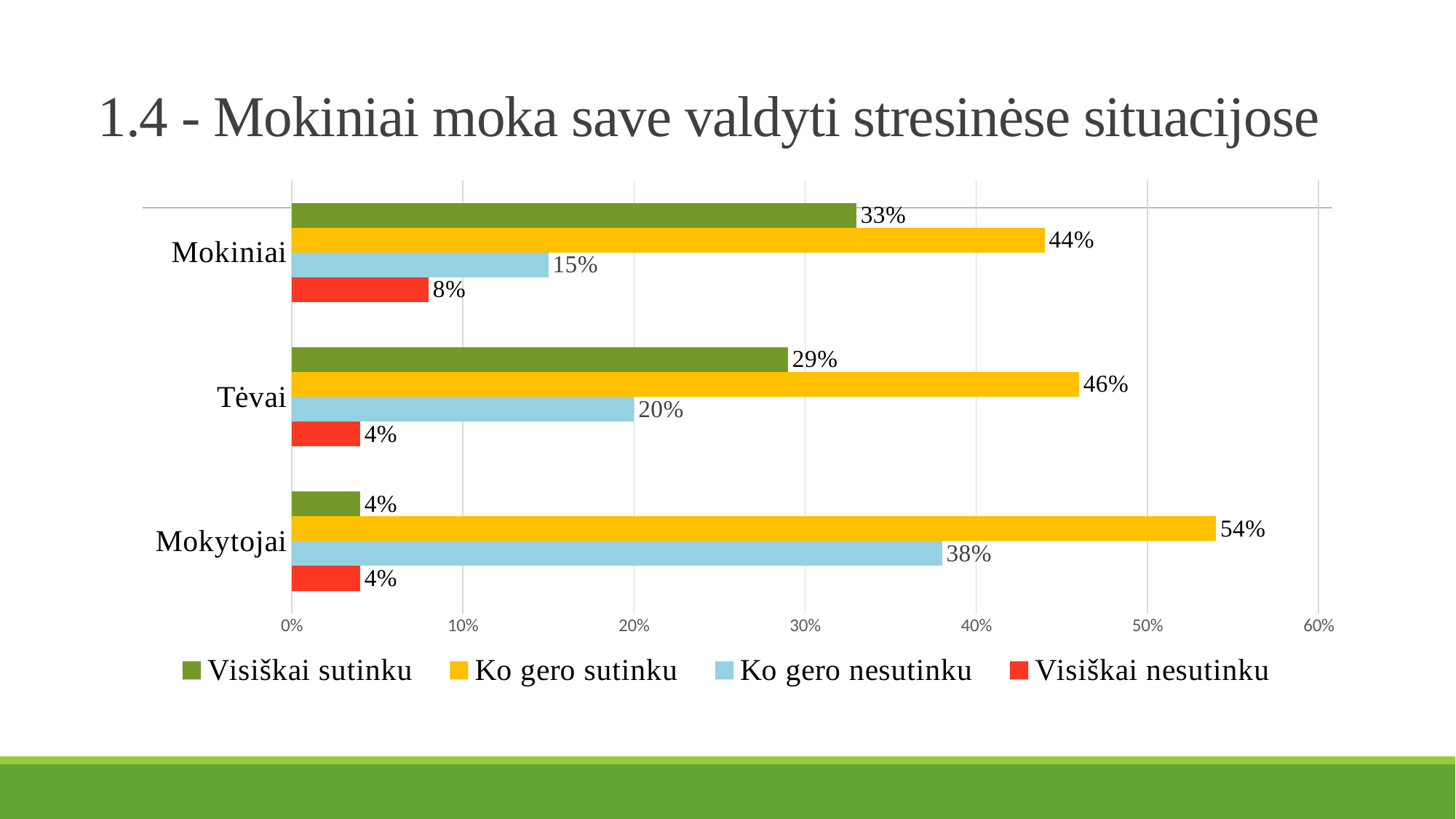
How many groups are shown on the y axis? 3 What kind of chart is shown on the slide? Bar chart Which group has the highest value for "Ko gero sutinku"? Mokytojai What is the difference between the "Ko gero nesutinku" values for Mokytojai and Mokiniai? 23% Which group has the lowest value for "Visiškai sutinku"? Mokytojai What is the value for "Ko gero nesutinku" for Tėvai? 20% What is the value for "Ko gero sutinku" for Mokytojai? 54% What is the value for "Visiškai sutinku" for Mokiniai? 33% What is the title of the chart? 1.4 - Mokiniai moka save valdyti stresinėse situacijose How many series does the legend list? 4 Which is larger: "Visiškai sutinku" for Mokiniai or "Visiškai sutinku" for Tėvai? Mokiniai Which colour represents "Visiškai nesutinku" in the legend? Red